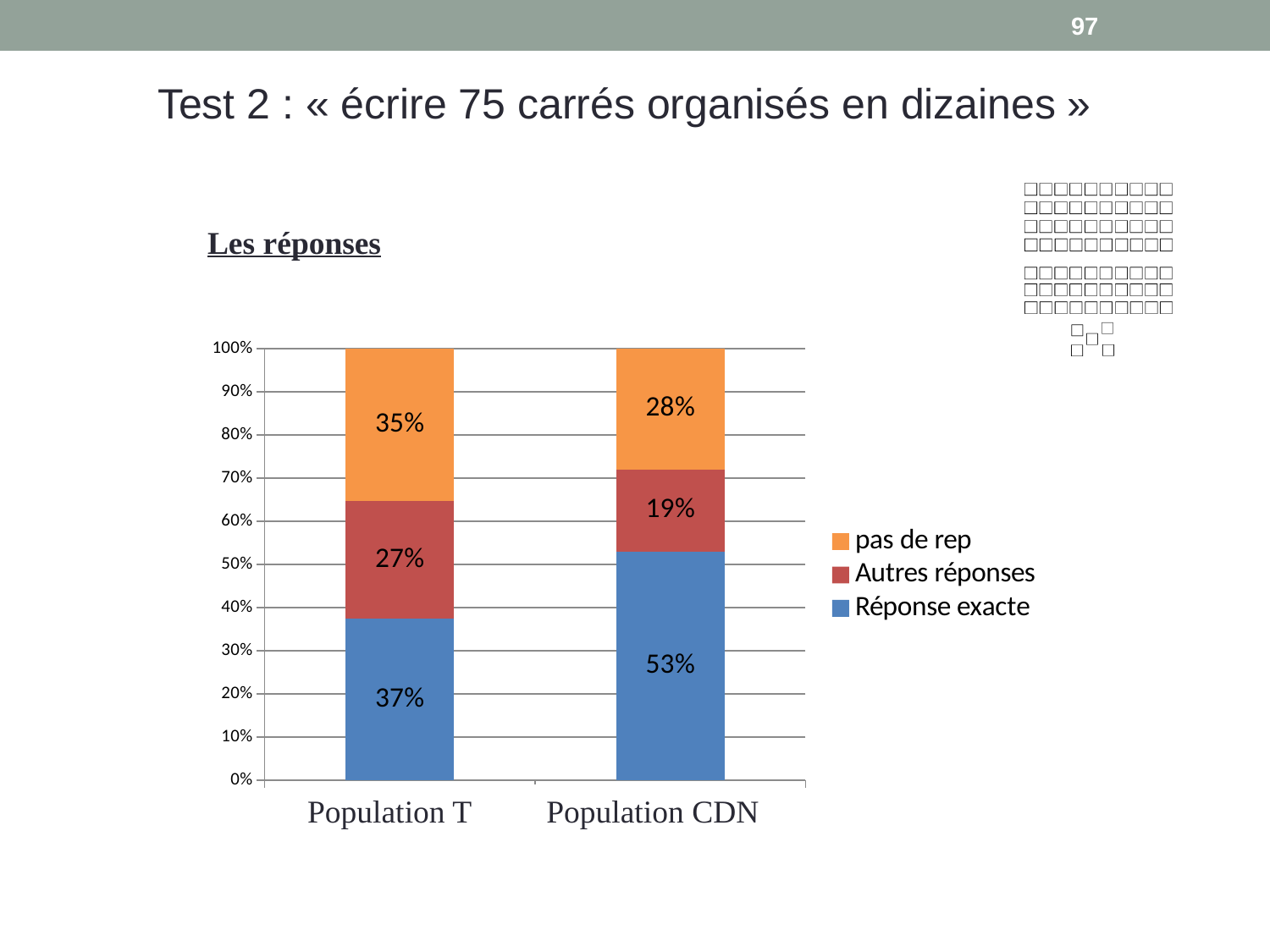
What is the difference between the "Autres réponses" values for Population T and Population CDN? 8% What is the value of "Réponse exacte" for Population T? 37% How many series does the legend list? 3 What is the value of "Autres réponses" for Population CDN? 19% Which population has the higher value for "Réponse exacte"? Population CDN Which legend entry is shown in blue? Réponse exacte How many categories are shown on the x axis? 2 What kind of chart is shown on the slide? Stacked bar chart What is the value of "pas de rep" for Population T? 35% What is the difference between the "Réponse exacte" values for Population CDN and Population T? 16% Which population has the higher value for "pas de rep"? Population T What is the value of "Réponse exacte" for Population CDN? 53%